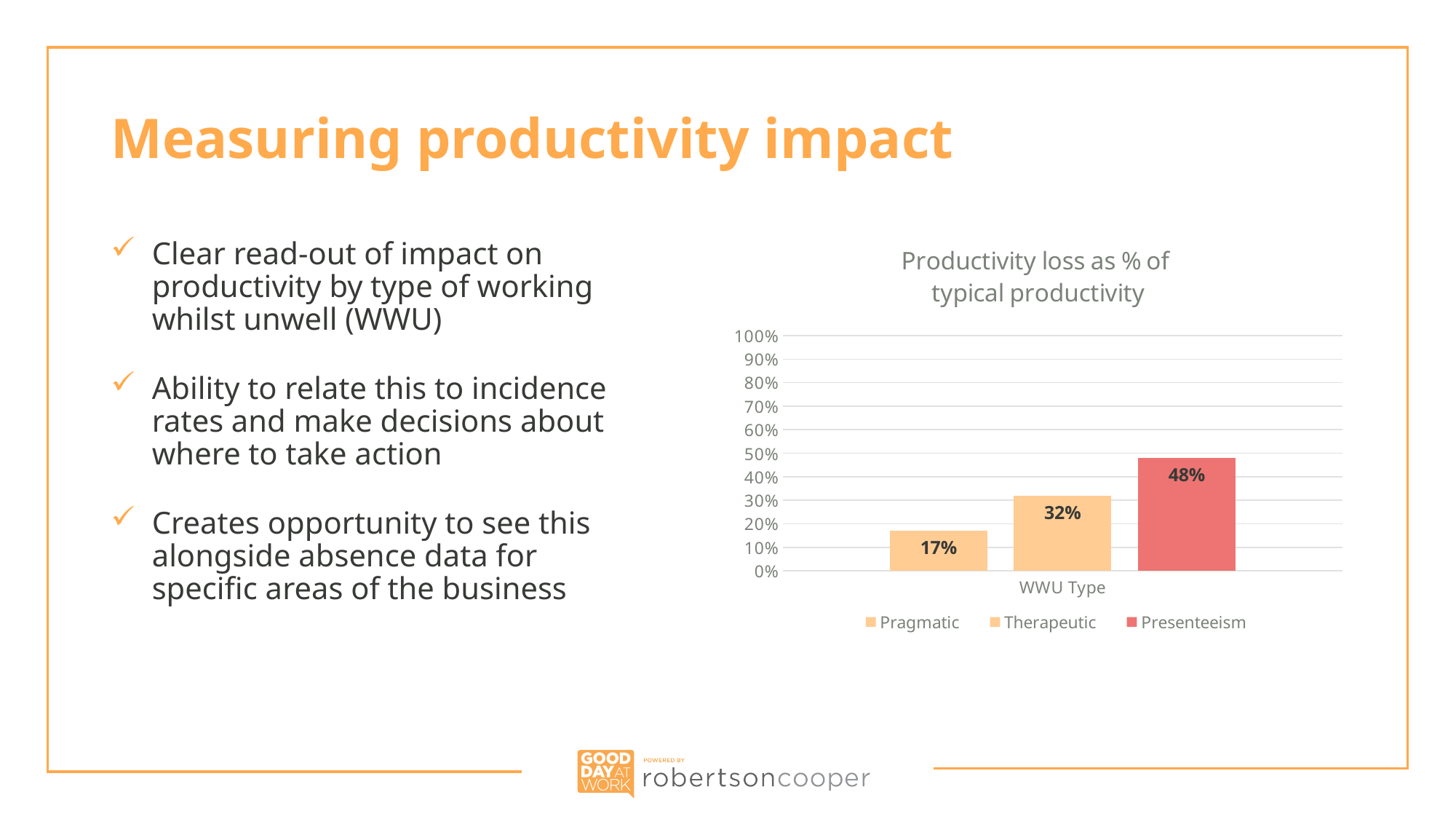
What is the title of the chart? Productivity loss as % of typical productivity What kind of chart is shown on the slide? Bar chart Which has a larger productivity loss, Therapeutic or Presenteeism? Presenteeism Is the productivity loss for Presenteeism greater or less than 50%? less Which WWU type has the highest productivity loss? Presenteeism What is the productivity loss for Presenteeism? 48% How many series does the legend list? 3 What is the productivity loss for Therapeutic WWU? 32% What is the difference in productivity loss between Presenteeism and Pragmatic? 31% Which WWU type has the lowest productivity loss? Pragmatic What is the productivity loss for Pragmatic WWU? 17% What is the difference in productivity loss between Therapeutic and Pragmatic? 15%